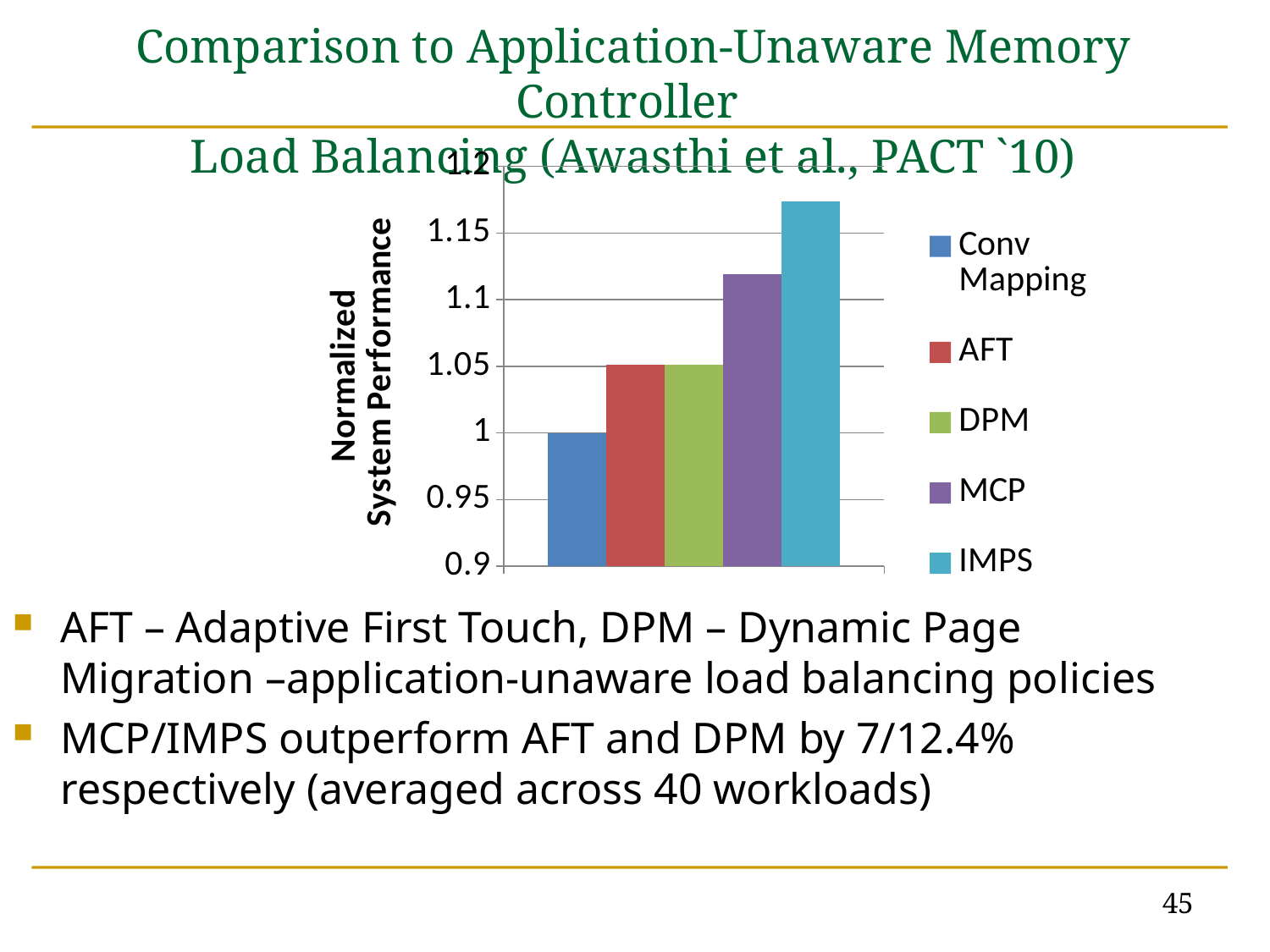
What kind of chart is shown on the slide? bar chart Which has a higher normalized system performance, IMPS or MCP? IMPS Which series has the lowest normalized system performance? Conv Mapping Which series has the highest normalized system performance? IMPS What is the title of the vertical axis? Normalized System Performance Is the value for AFT greater or less than 1.1? less Is the value for DPM greater or less than 1? greater What is the normalized system performance for Conv Mapping? 1 Is the value for IMPS greater or less than 1.15? greater Which has a higher normalized system performance, MCP or AFT? MCP How many series does the legend list? 5